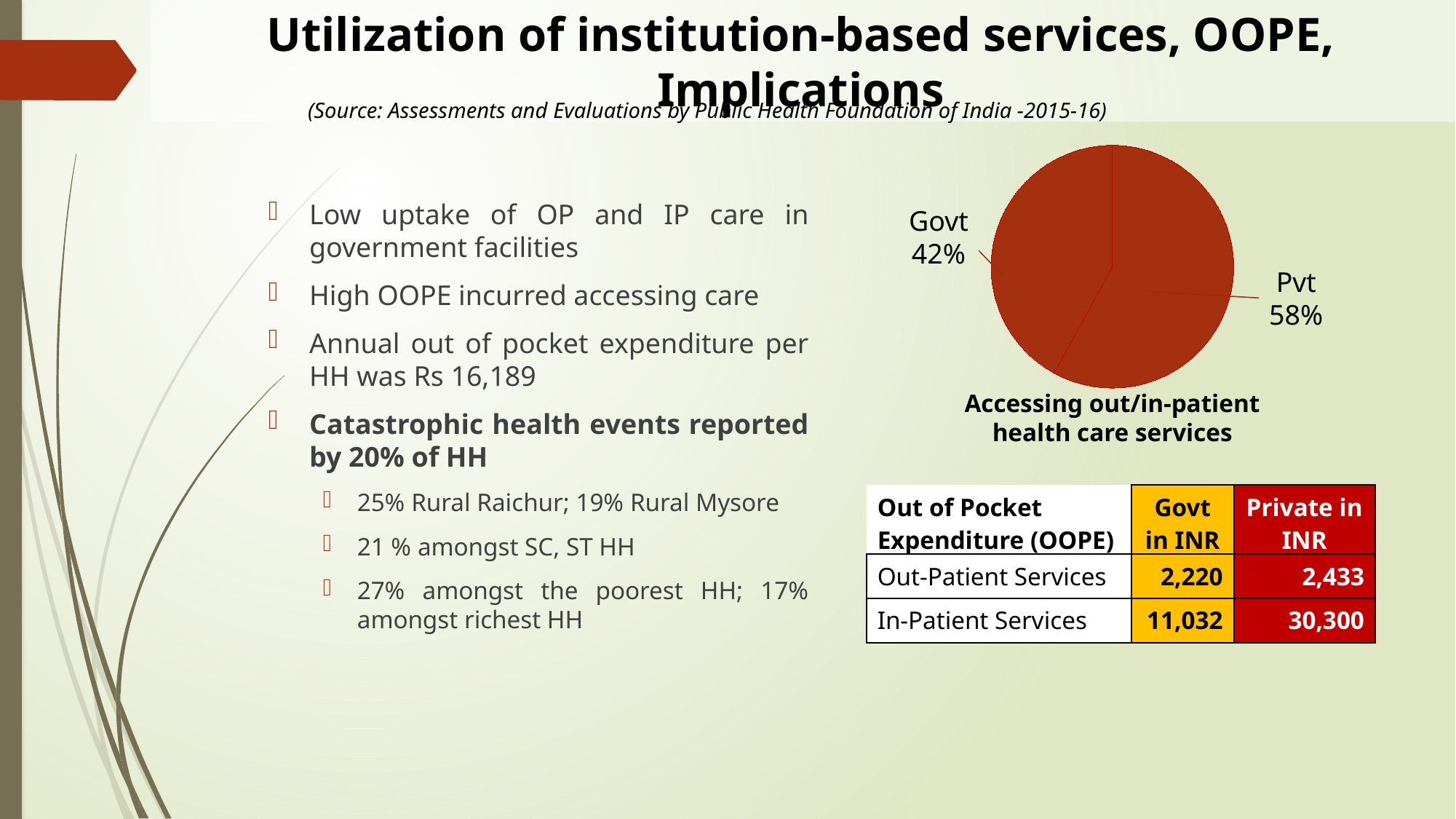
Which is larger in the pie chart, the Govt slice or the Pvt slice? Pvt Which slice of the pie chart is the largest? Pvt What share of the pie does the Govt slice represent? 42% Which slice of the pie chart is the smallest? Govt How many slices does the pie chart have? 2 What is the difference in percentage points between the Pvt slice and the Govt slice? 16 What colour are the slices of the pie chart? red What share of the pie does the Pvt slice represent? 58% What is the title of the pie chart? Accessing out/in-patient health care services What kind of chart is shown on the slide? pie chart